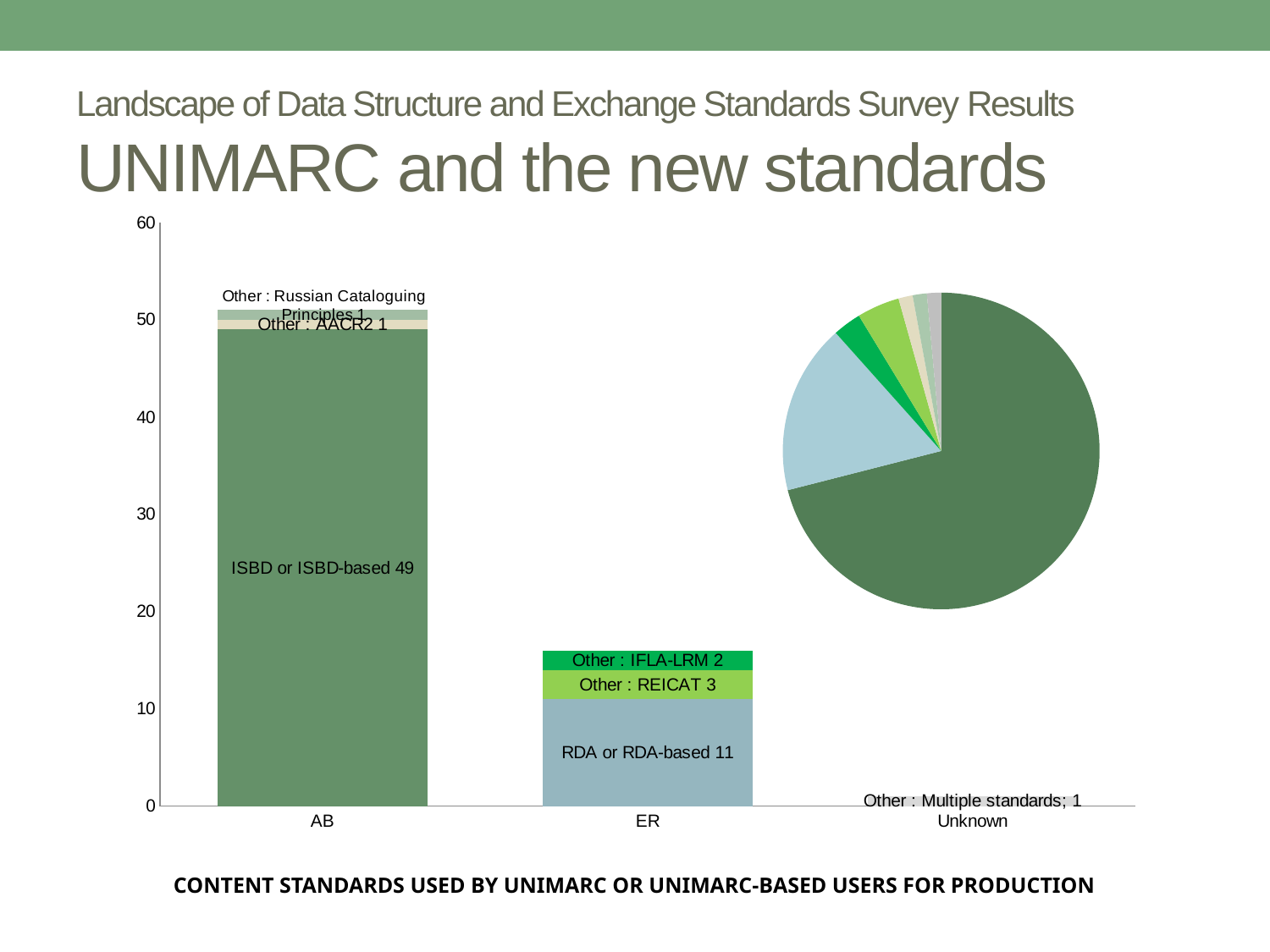
In the bar chart on the left, which category has the tallest stacked bar? AB In the bar chart on the left, how many categories are shown on the x axis? 3 In the bar chart on the left, which category has the smallest total? Unknown In the bar chart on the left, what is the total of the stacked bar for ER? 16 In the bar chart on the left, what is the total of the stacked bar for AB? 51 In the bar chart on the left, what is the value for Other : IFLA-LRM in the ER category? 2 In the bar chart on the left, what is the value for ISBD or ISBD-based in the AB category? 49 What kind of chart is shown on the right side of the slide? Pie chart In the bar chart on the left, what is the value for Other : Multiple standards in the Unknown category? 1 In the bar chart on the left, what is the value for RDA or RDA-based in the ER category? 11 In the bar chart on the left, what is the value for Other : REICAT in the ER category? 3 In the bar chart on the left, what is the difference between the ISBD or ISBD-based value (AB) and the RDA or RDA-based value (ER)? 38